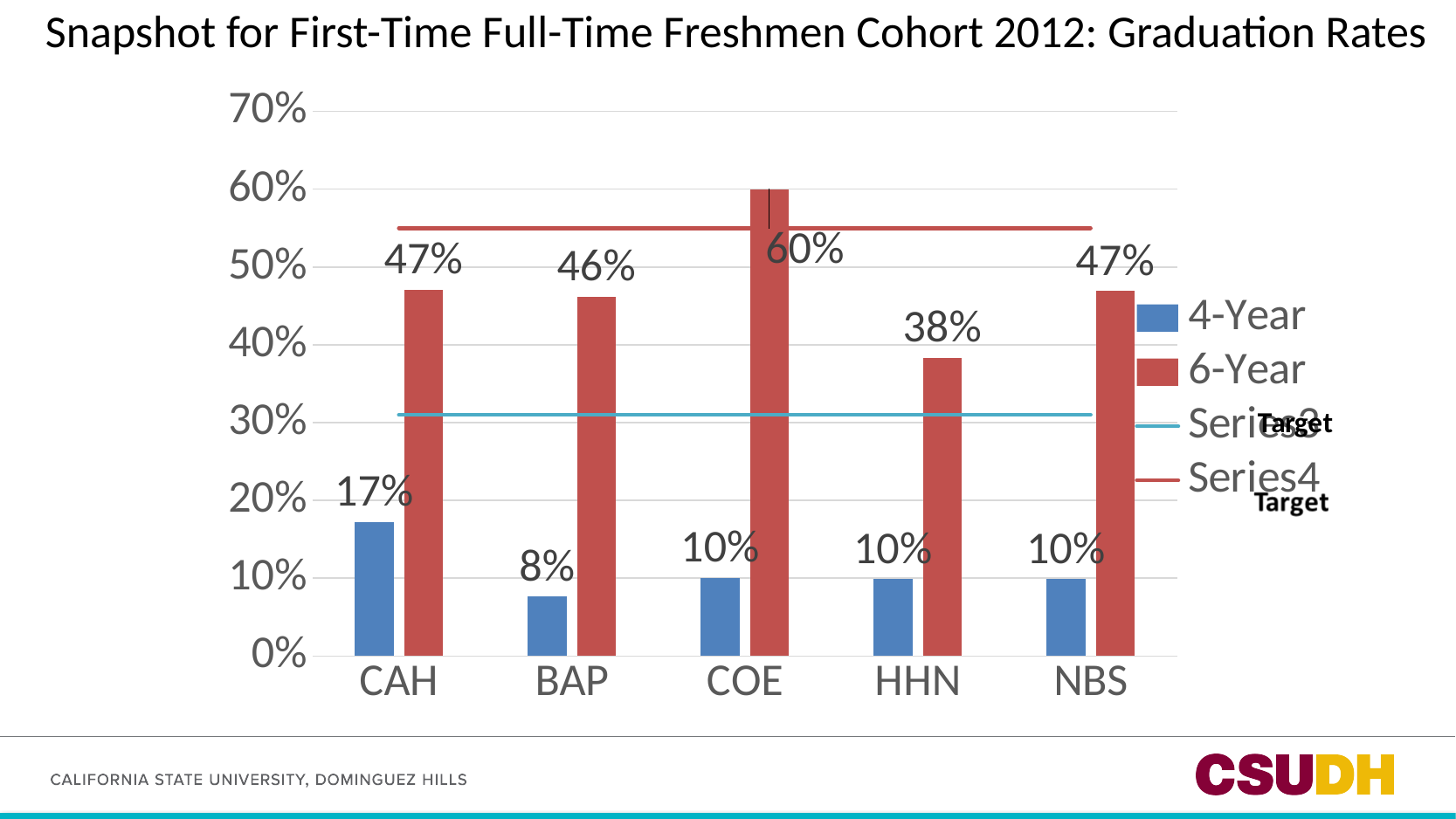
How many entries does the legend list? 4 How many colleges are shown on the x axis? 5 What is the 4-Year graduation rate for CAH? 17% What is the 4-Year graduation rate for BAP? 8% What is the 6-Year graduation rate for HHN? 38% What is the difference between the 6-Year and 4-Year graduation rates for COE? 50% What type of chart is shown on the slide? Combination bar and line chart Which is larger, the 6-Year rate for CAH or the 6-Year rate for HHN? CAH Which college has the highest 6-Year graduation rate? COE What is the 6-Year graduation rate for COE? 60% Which college has the lowest 6-Year graduation rate? HHN Which college has the lowest 4-Year graduation rate? BAP